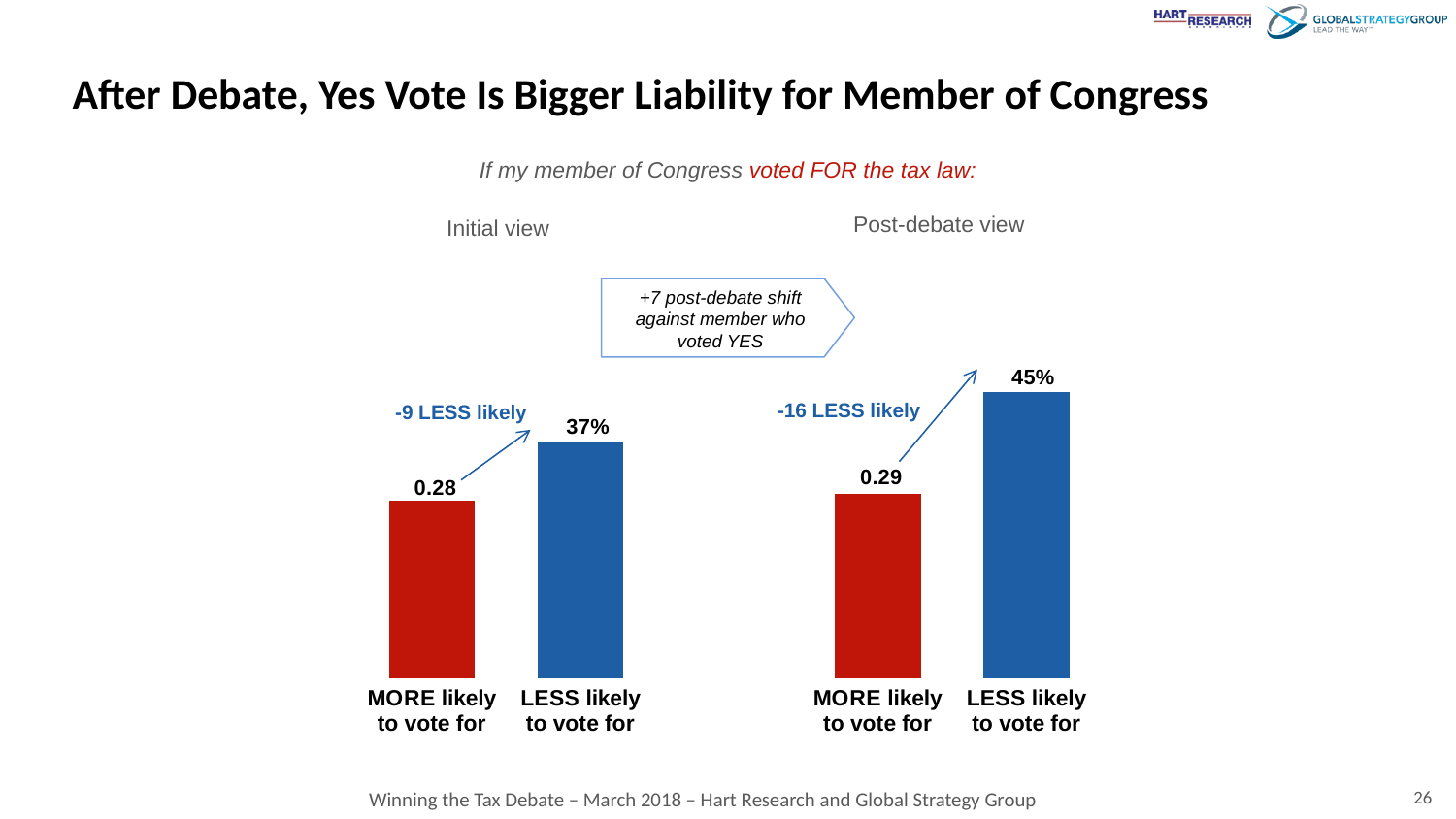
In the Post-debate view chart, which category has the higher bar? LESS likely to vote for In the Initial view chart, which category has the lower bar? MORE likely to vote for What net shift is annotated above the Post-debate view chart? -16 LESS likely Is the LESS likely to vote for bar larger in the Initial view chart or the Post-debate view chart? Post-debate view What type of chart is the Post-debate view chart? Bar chart How many bars are in the Initial view chart? 2 What colour is the MORE likely to vote for bar in the Initial view chart? Red In the Post-debate view chart, what is the value for LESS likely to vote for? 45% In the Initial view chart, what is the value for LESS likely to vote for? 37% In the Initial view chart, what is the value for MORE likely to vote for? 0.28 In the Post-debate view chart, what is the value for MORE likely to vote for? 0.29